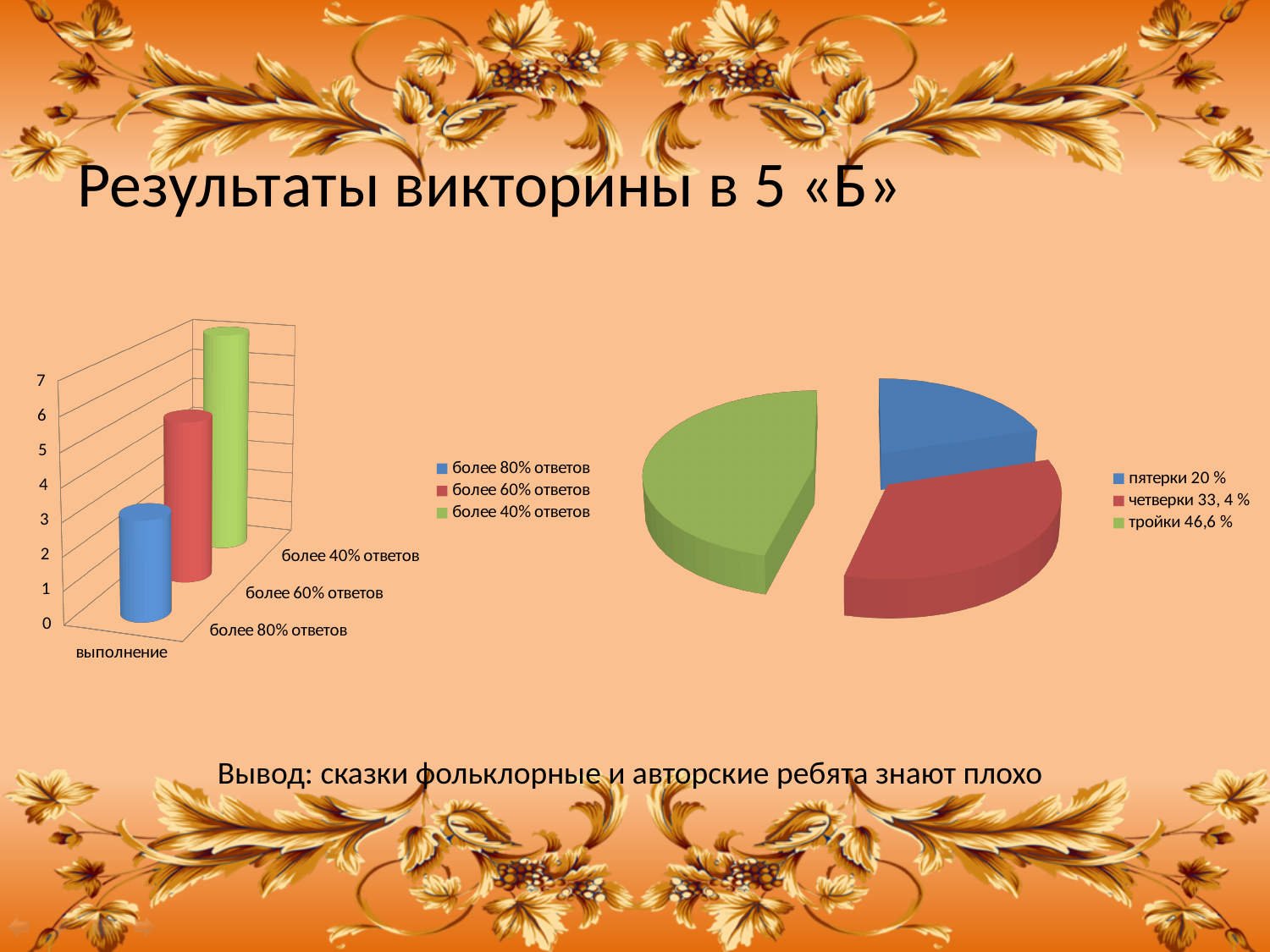
In the bar chart on the left, is the value for 'более 80% ответов' greater or less than 5? less In the pie chart on the right, how many slices are there? 3 In the bar chart on the left, which series has the tallest bar? более 40% ответов In the pie chart on the right, what share does 'пятерки' have according to the legend? 20 % In the bar chart on the left, is the value for 'более 40% ответов' greater or less than 5? greater In the bar chart on the left, which series has the shortest bar? более 80% ответов What kind of chart is the chart on the left of the slide? bar chart In the bar chart on the left, which is larger: the bar for 'более 60% ответов' or the bar for 'более 80% ответов'? более 60% ответов In the pie chart on the right, which slice is the largest? тройки 46,6 % In the pie chart on the right, what share does 'тройки' have according to the legend? 46,6 % In the bar chart on the left, how many series does the legend list? 3 What kind of chart is the chart on the right of the slide? pie chart